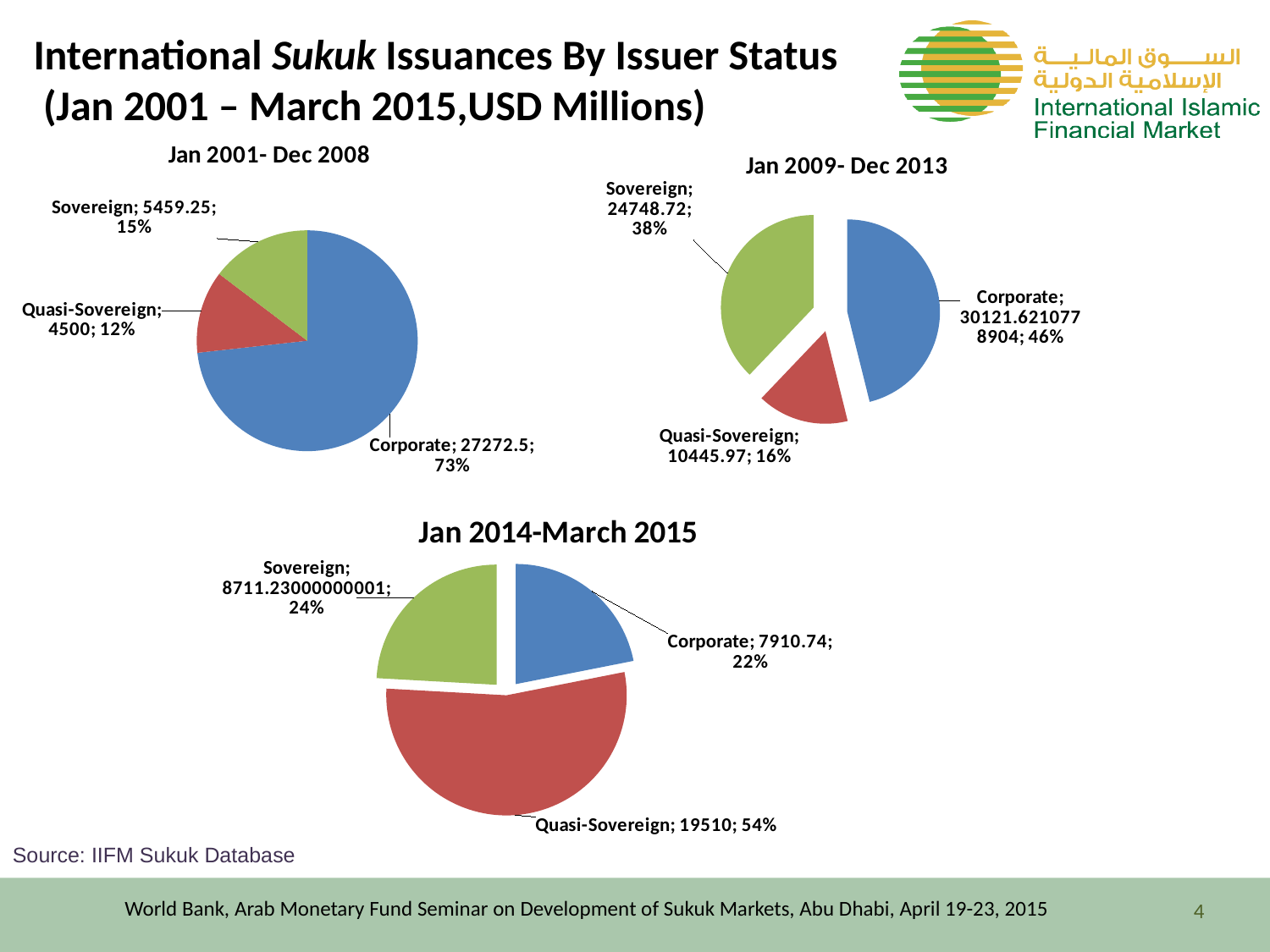
In the 'Jan 2009- Dec 2013' chart, which category has the largest slice? Corporate In the 'Jan 2001- Dec 2008' chart, what share of the pie does Sovereign represent? 15% In the 'Jan 2001- Dec 2008' chart, what is the difference between the Sovereign and Quasi-Sovereign values? 959.25 In the 'Jan 2001- Dec 2008' chart, which category has the smallest slice? Quasi-Sovereign In the 'Jan 2014-March 2015' chart, what is the value for Quasi-Sovereign? 19510 In the 'Jan 2014-March 2015' chart, what is the difference between the Quasi-Sovereign and Corporate values? 11599.26 In the 'Jan 2009- Dec 2013' chart, what share of the pie does Sovereign represent? 38% In the 'Jan 2001- Dec 2008' chart, what is the value for Corporate? 27272.5 In the 'Jan 2014-March 2015' chart, what share of the pie does Corporate represent? 22% What type of chart is the 'Jan 2009- Dec 2013' chart? Pie chart In the 'Jan 2009- Dec 2013' chart, what is the value for Quasi-Sovereign? 10445.97 How many slices does the 'Jan 2014-March 2015' chart have? 3